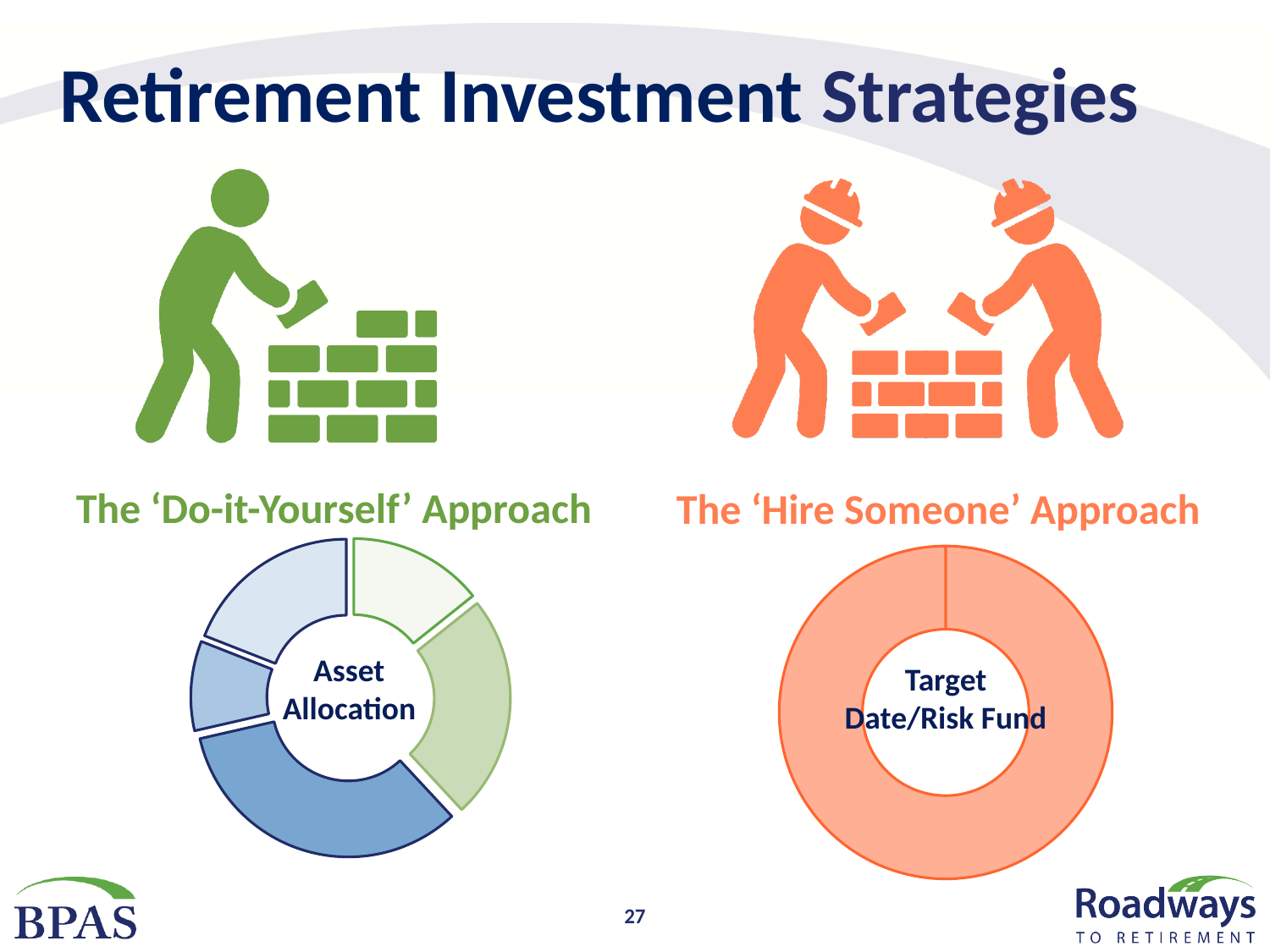
What kind of chart is shown under 'The Do-it-Yourself Approach' on the left? Doughnut chart In the left 'Asset Allocation' doughnut chart, which colour segment is the largest? Dark blue What text appears in the centre of the left doughnut chart? Asset Allocation What text appears in the centre of the right doughnut chart? Target Date/Risk Fund How many segments does the left 'Asset Allocation' doughnut chart have? 5 What kind of chart is shown under 'The Hire Someone Approach' on the right? Doughnut chart In the left 'Asset Allocation' doughnut chart, which colour segment is the smallest? Medium blue How many segments does the right 'Target Date/Risk Fund' doughnut chart have? 1